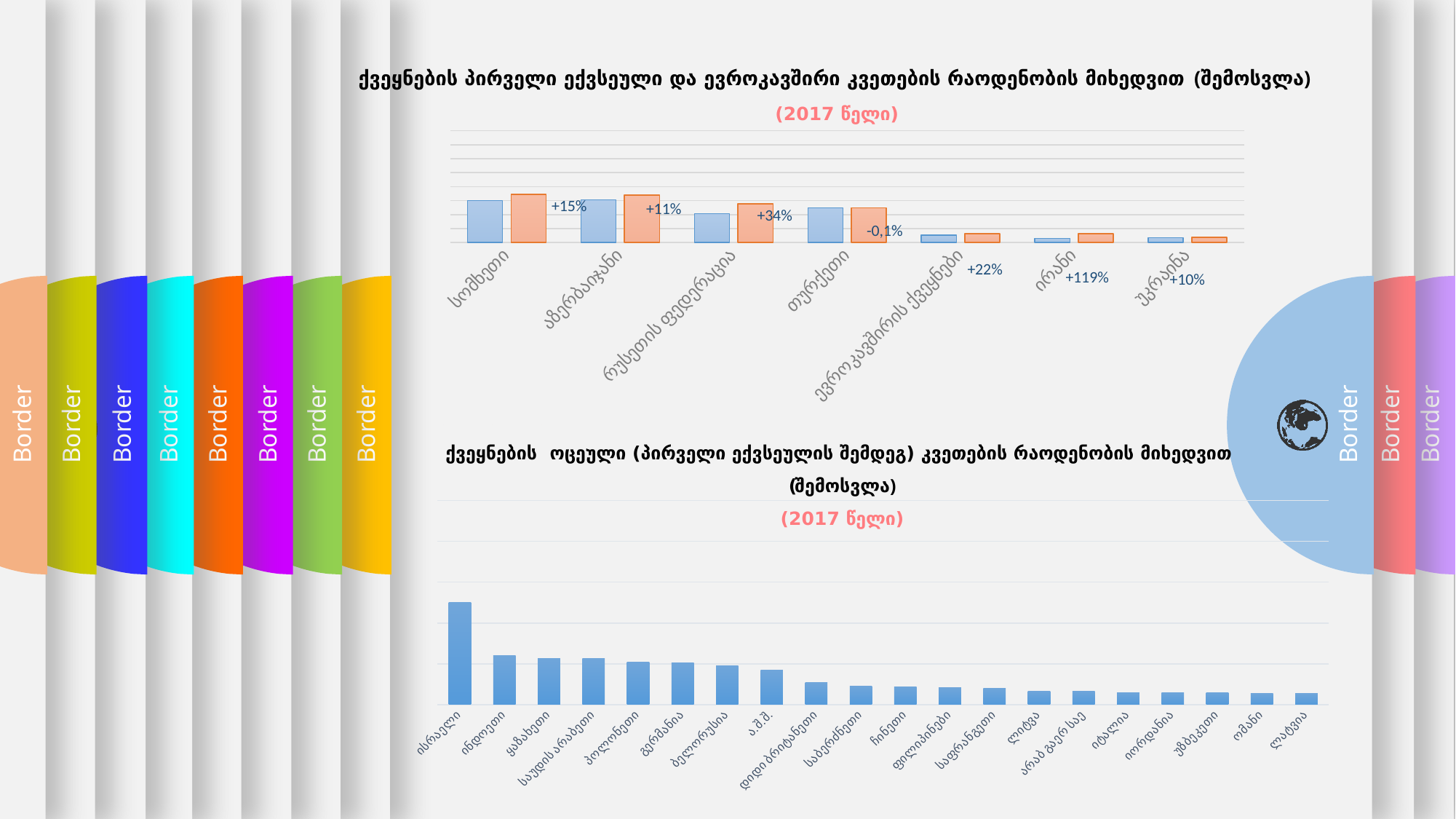
In the top chart, what percentage change is labelled for რუსეთის ფედერაცია? +34% What type of chart is the bottom chart on the slide? bar chart In the top chart, how many categories are shown on the x axis? 7 In the top chart, what percentage change is labelled for ირანი? +119% In the bottom chart, how many countries are shown on the x axis? 20 In the top chart, what percentage change is labelled for სომხეთი? +15% In the top chart, what percentage change is labelled for აზერბაიჯანი? +11% What type of chart is the top chart on the slide? bar chart In the bottom chart, which country has the highest bar? ისრაელი In the top chart, what percentage change is labelled for უკრაინა? +10% In the top chart, what percentage change is labelled for თურქეთი? -0,1% In the bottom chart, do the bar values generally rise or fall from left to right? fall